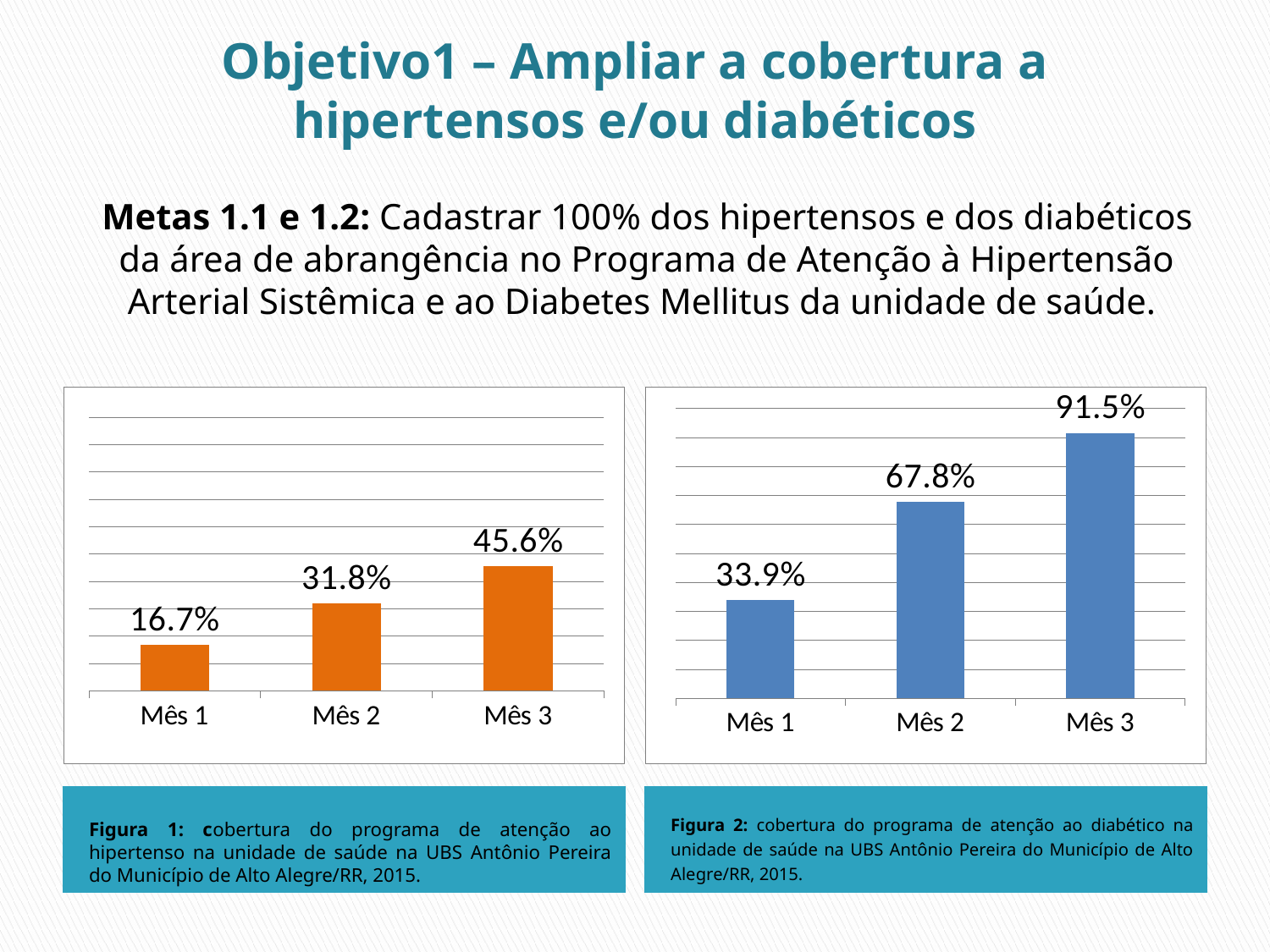
Which is larger: the value for Mês 3 in the left chart (Figura 1) or the value for Mês 1 in the right chart (Figura 2)? Mês 3 in the left chart In the right chart (Figura 2), do the values rise or fall from Mês 1 to Mês 3? Rise What kind of chart is the left chart (Figura 1)? Bar chart In the right chart (Figura 2), what is the difference between the values for Mês 2 and Mês 1? 33.9% In the left chart (Figura 1), what is the difference between the values for Mês 3 and Mês 1? 28.9% In the right chart (Figura 2), which month has the highest value? Mês 3 In the right chart (Figura 2), what is the value for Mês 3? 91.5% What colour are the bars in the left chart (Figura 1)? Orange In the left chart (Figura 1), what is the value for Mês 2? 31.8% How many categories are shown on the x axis of the right chart (Figura 2)? 3 In the left chart (Figura 1), which month has the lowest value? Mês 1 In the left chart (Figura 1), what is the value for Mês 1? 16.7%